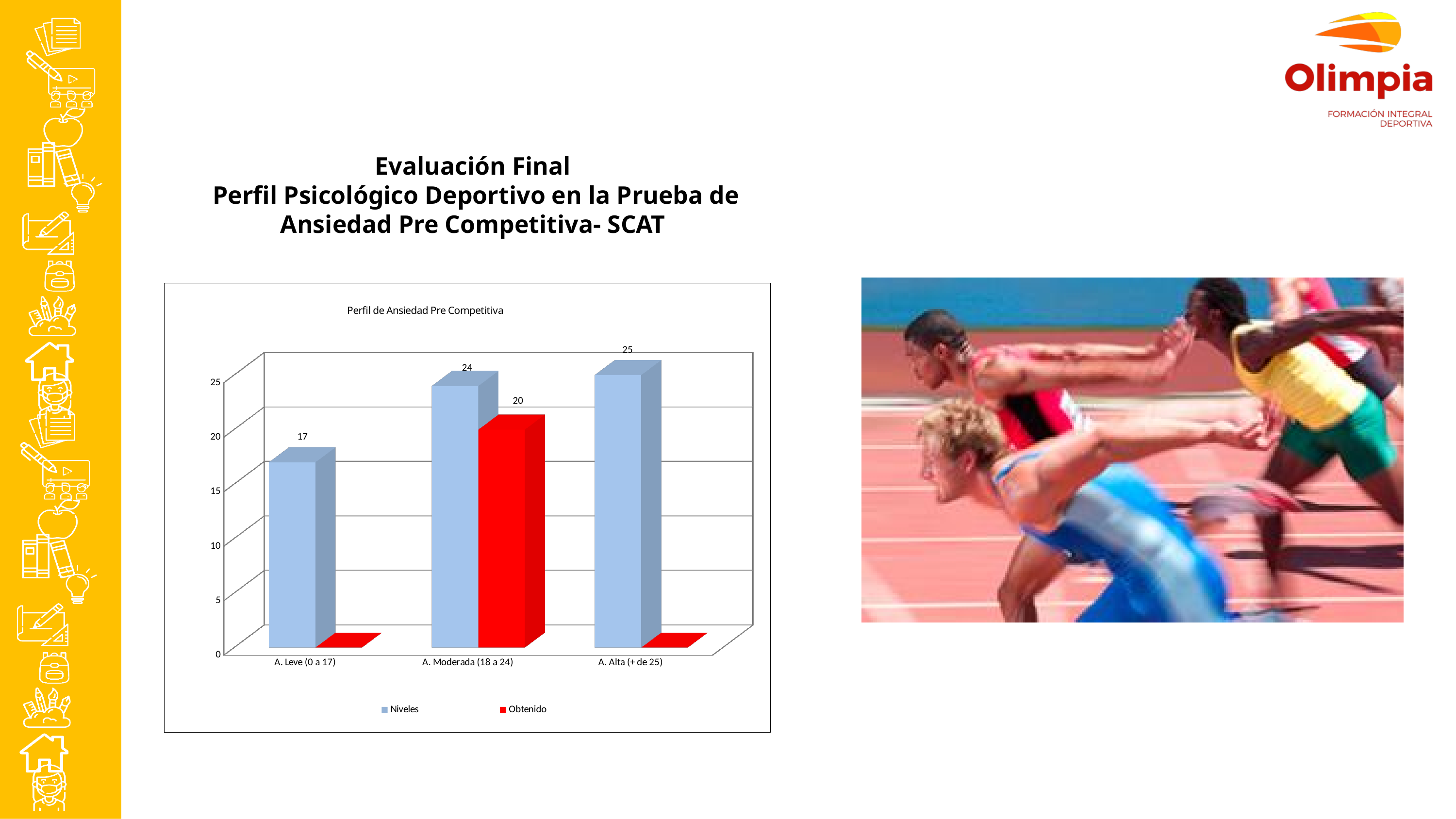
How many categories are shown on the x axis of the chart? 3 What is the Obtenido value for A. Moderada (18 a 24)? 20 What is the Niveles value for A. Leve (0 a 17)? 17 Which category has the highest Niveles value? A. Alta (+ de 25) What is the title of the chart? Perfil de Ansiedad Pre Competitiva How many series does the chart legend list? 2 What is the Niveles value for A. Alta (+ de 25)? 25 What kind of chart is shown on the slide? Bar chart What is the difference between the Niveles value for A. Alta (+ de 25) and the Niveles value for A. Leve (0 a 17)? 8 For A. Moderada (18 a 24), which is larger, the Niveles value or the Obtenido value? Niveles What is the Niveles value for A. Moderada (18 a 24)? 24 Which category has the lowest Niveles value? A. Leve (0 a 17)